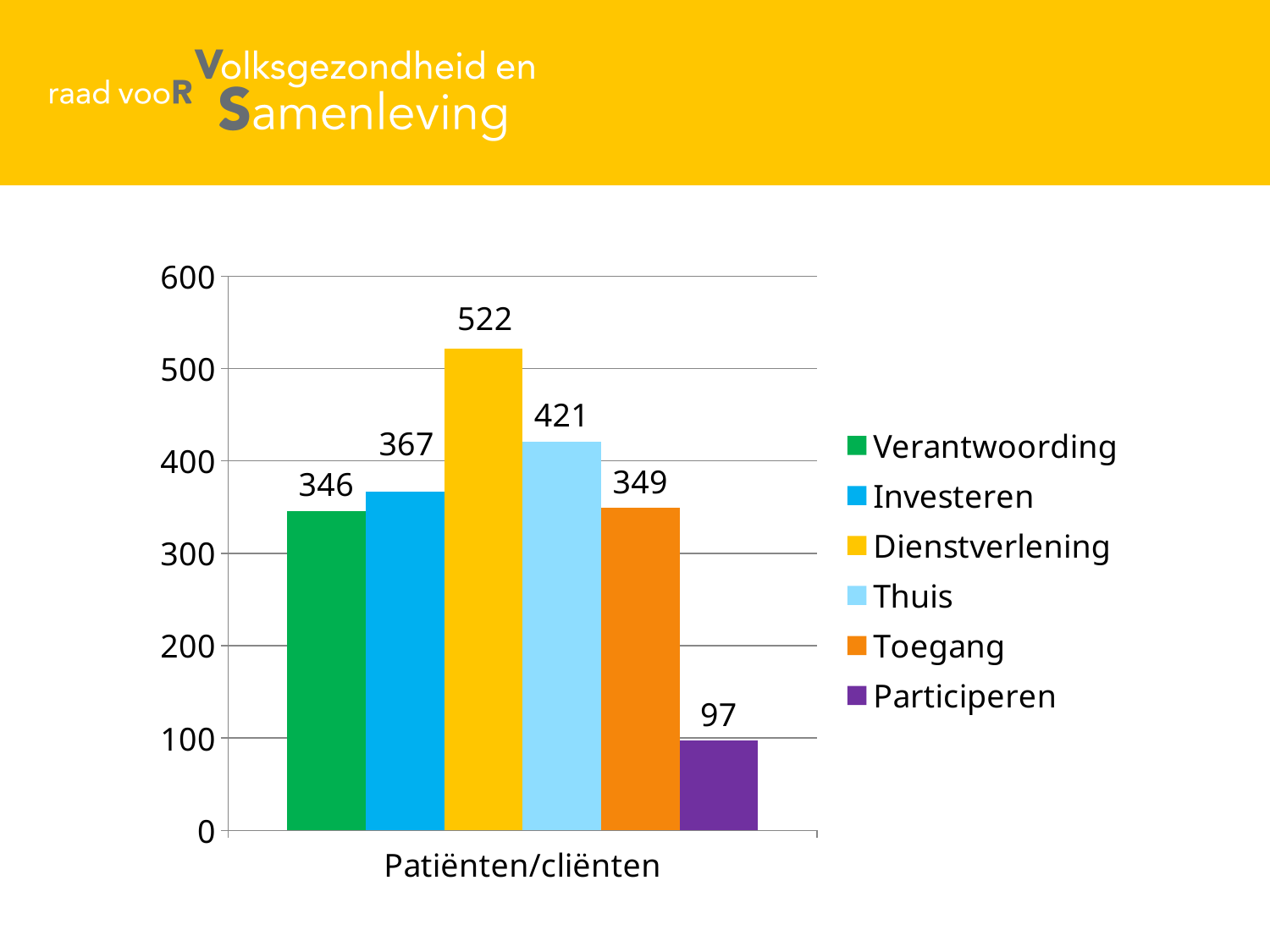
Which series has the highest value for Patiënten/cliënten? Dienstverlening Which is larger, the value for Toegang or the value for Thuis? Thuis What is the value for Thuis for Patiënten/cliënten? 421 What is the difference between the values for Dienstverlening and Thuis? 101 What is the difference between the values for Investeren and Verantwoording? 21 What is the label on the x axis of the chart? Patiënten/cliënten What kind of chart is shown on the slide? bar chart What is the value for Dienstverlening for Patiënten/cliënten? 522 Which series has the lowest value for Patiënten/cliënten? Participeren How many series does the legend list? 6 Is the value for Verantwoording greater or less than 300? greater What is the value for Participeren for Patiënten/cliënten? 97